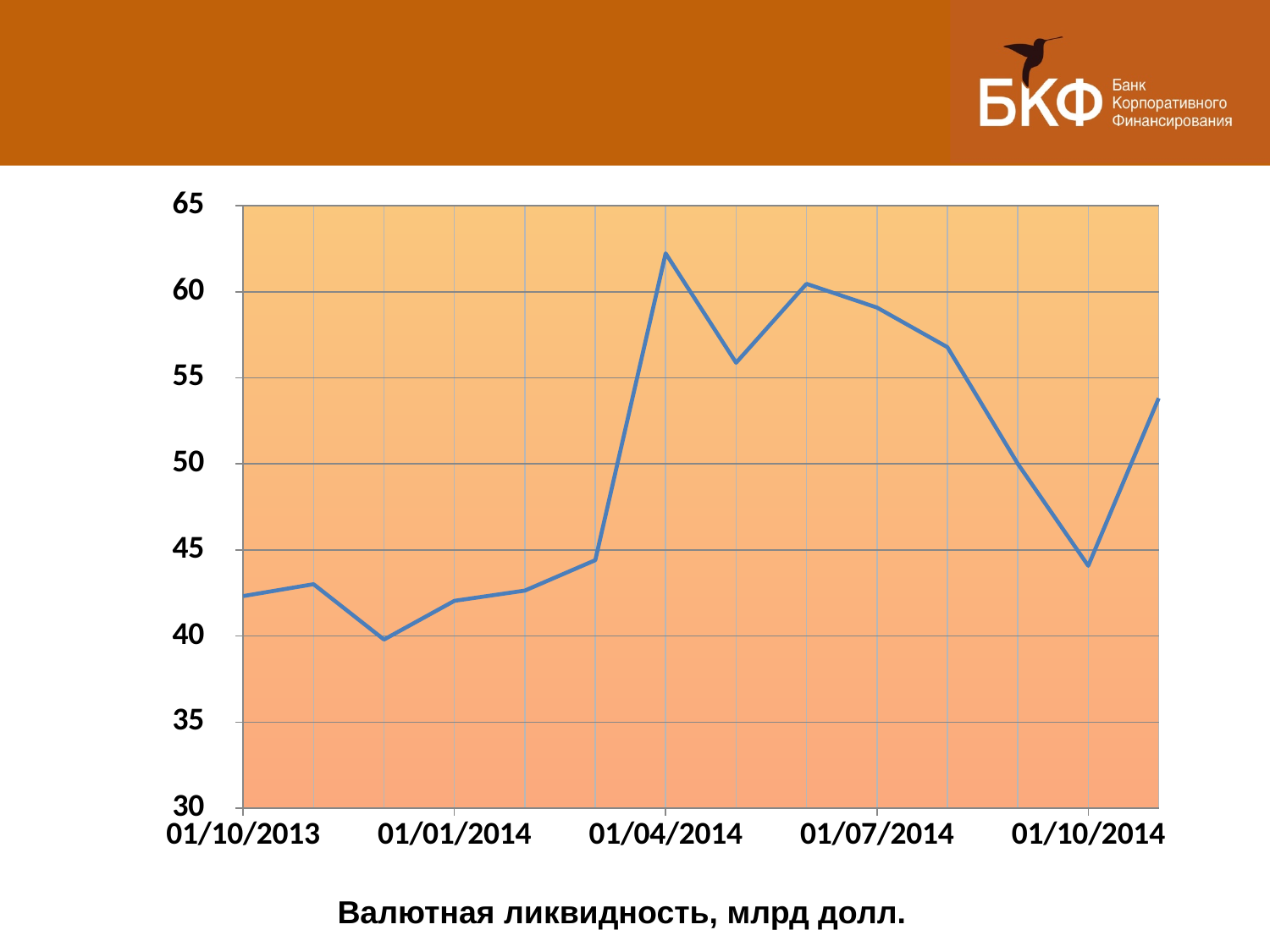
Is the value at 01/04/2014 greater or less than 60? greater Is the value at 01/10/2013 greater or less than 45? less What is the title of the chart? Валютная ликвидность, млрд долл. At which labelled date on the x axis does the line reach its highest value? 01/04/2014 Which is larger, the value at 01/04/2014 or the value at 01/10/2013? 01/04/2014 Does the line rise or fall between 01/07/2014 and 01/10/2014? fall What is the highest value shown on the y axis? 65 Which is larger, the value at 01/07/2014 or the value at 01/10/2014? 01/07/2014 What kind of chart is shown on the slide? line chart Is the value at 01/10/2014 greater or less than 45? less